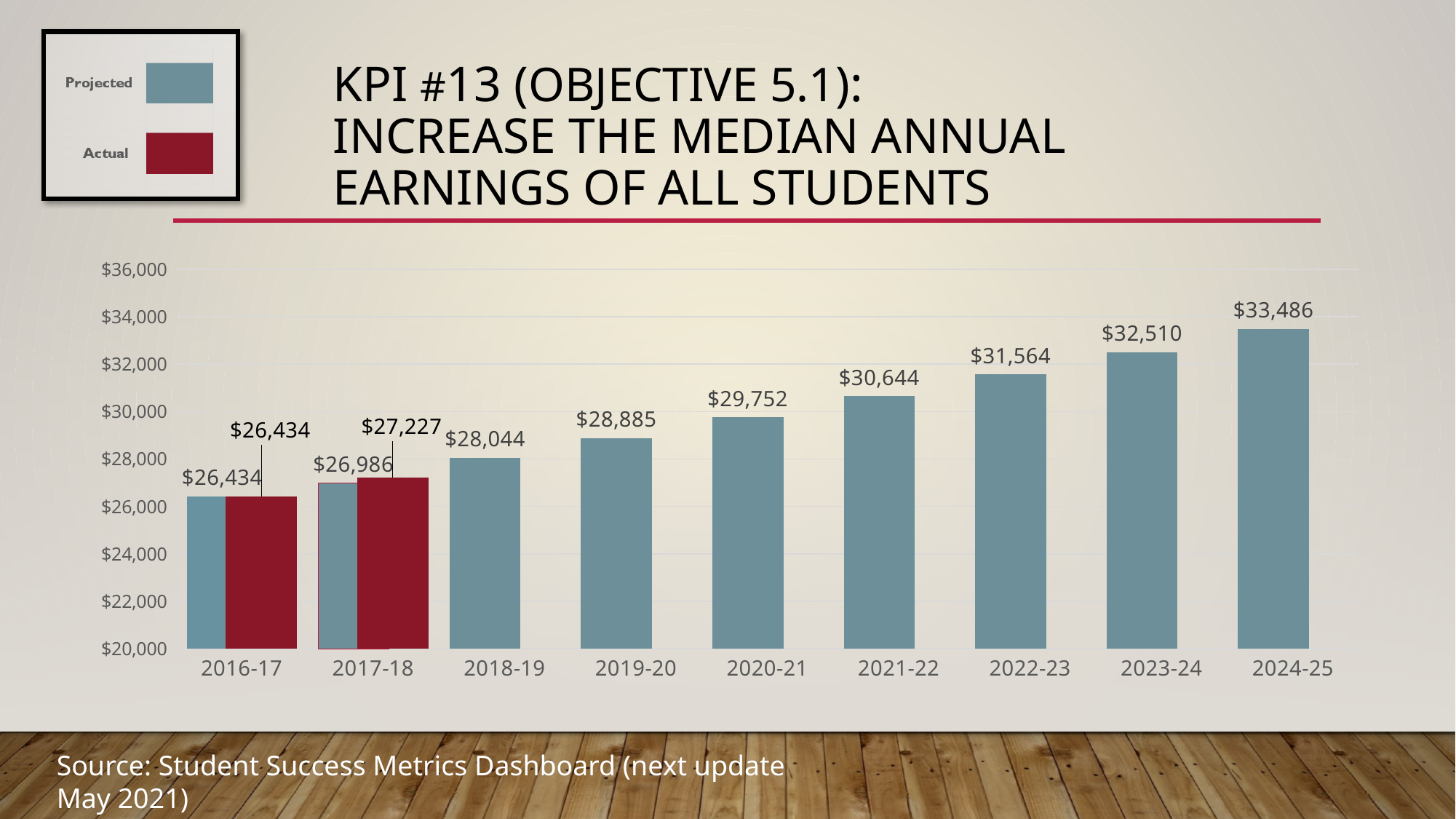
Which year has the lowest projected median annual earnings? 2016-17 How many academic years are shown on the x axis? 9 What is the difference between the projected median annual earnings for 2024-25 and 2016-17? $7,052 What is the difference between the actual and projected median annual earnings for 2017-18? $241 What is the actual median annual earnings for 2017-18? $27,227 How many series does the legend list? 2 For 2017-18, which is larger: the projected or the actual median annual earnings? Actual What kind of chart is shown on the slide? Bar chart Do the projected median annual earnings rise or fall from 2016-17 to 2024-25? Rise Which year has the highest projected median annual earnings? 2024-25 What is the projected median annual earnings for 2024-25? $33,486 What is the projected median annual earnings for 2020-21? $29,752